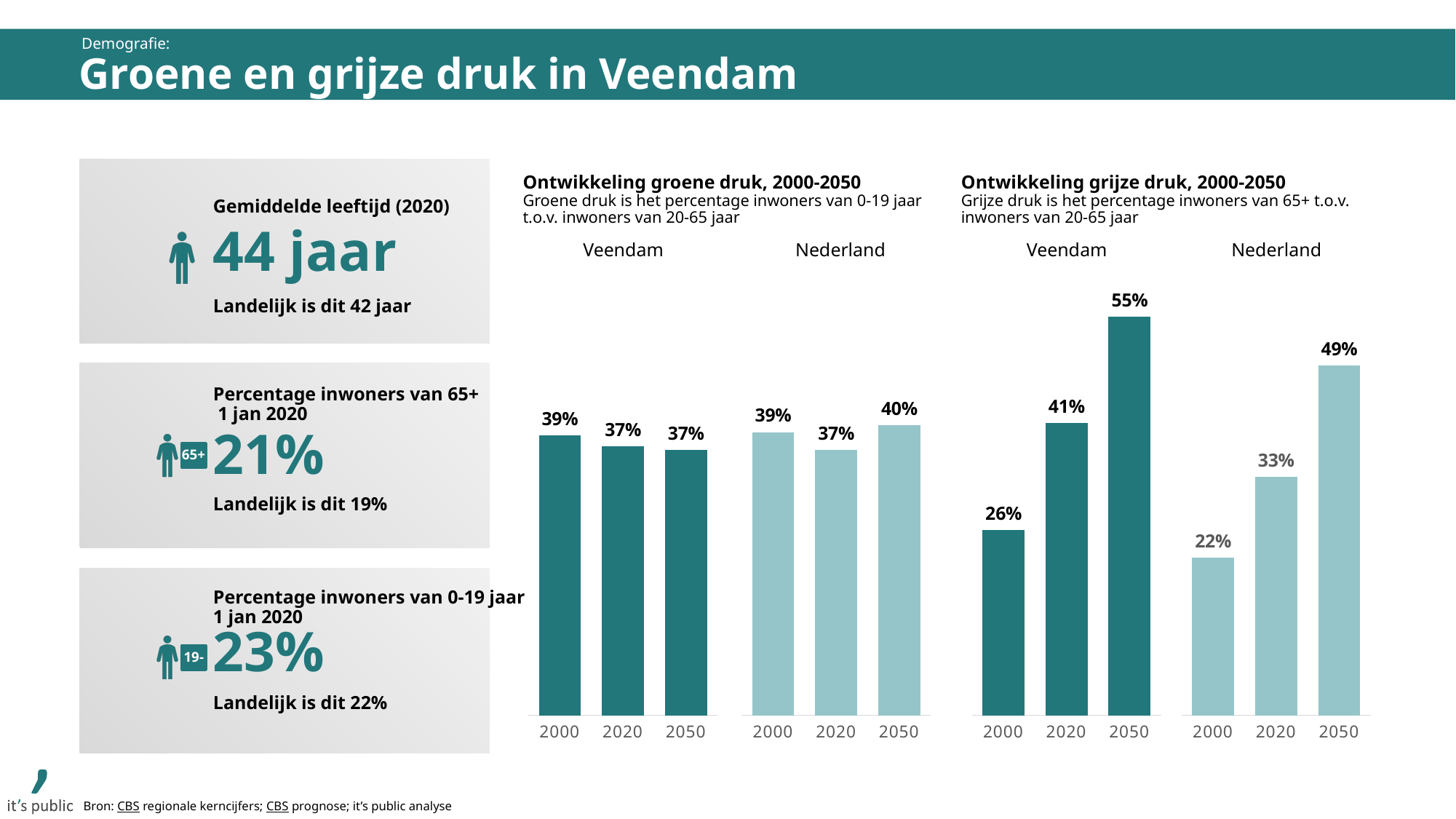
How many bars are shown in the 'Ontwikkeling groene druk, 2000-2050' chart? 6 In the 'Ontwikkeling grijze druk, 2000-2050' chart, which bar has the lowest value? Nederland 2000 In the 'Ontwikkeling grijze druk, 2000-2050' chart, do the values for Veendam rise or fall from 2000 to 2050? rise In the 'Ontwikkeling groene druk, 2000-2050' chart, what is the difference between Veendam in 2000 and Veendam in 2020? 2% In the 'Ontwikkeling groene druk, 2000-2050' chart, what is the value for Veendam in 2000? 39% What kind of chart is 'Ontwikkeling grijze druk, 2000-2050'? bar chart In the 'Ontwikkeling groene druk, 2000-2050' chart, what is the value for Nederland in 2050? 40% In the 'Ontwikkeling grijze druk, 2000-2050' chart, what is the difference between Veendam and Nederland in 2050? 6% In the 'Ontwikkeling grijze druk, 2000-2050' chart, which is larger: Veendam in 2020 or Nederland in 2020? Veendam in 2020 In the 'Ontwikkeling grijze druk, 2000-2050' chart, what is the value for Veendam in 2050? 55% In the 'Ontwikkeling grijze druk, 2000-2050' chart, what is the value for Nederland in 2000? 22% In the 'Ontwikkeling grijze druk, 2000-2050' chart, which bar has the highest value? Veendam 2050